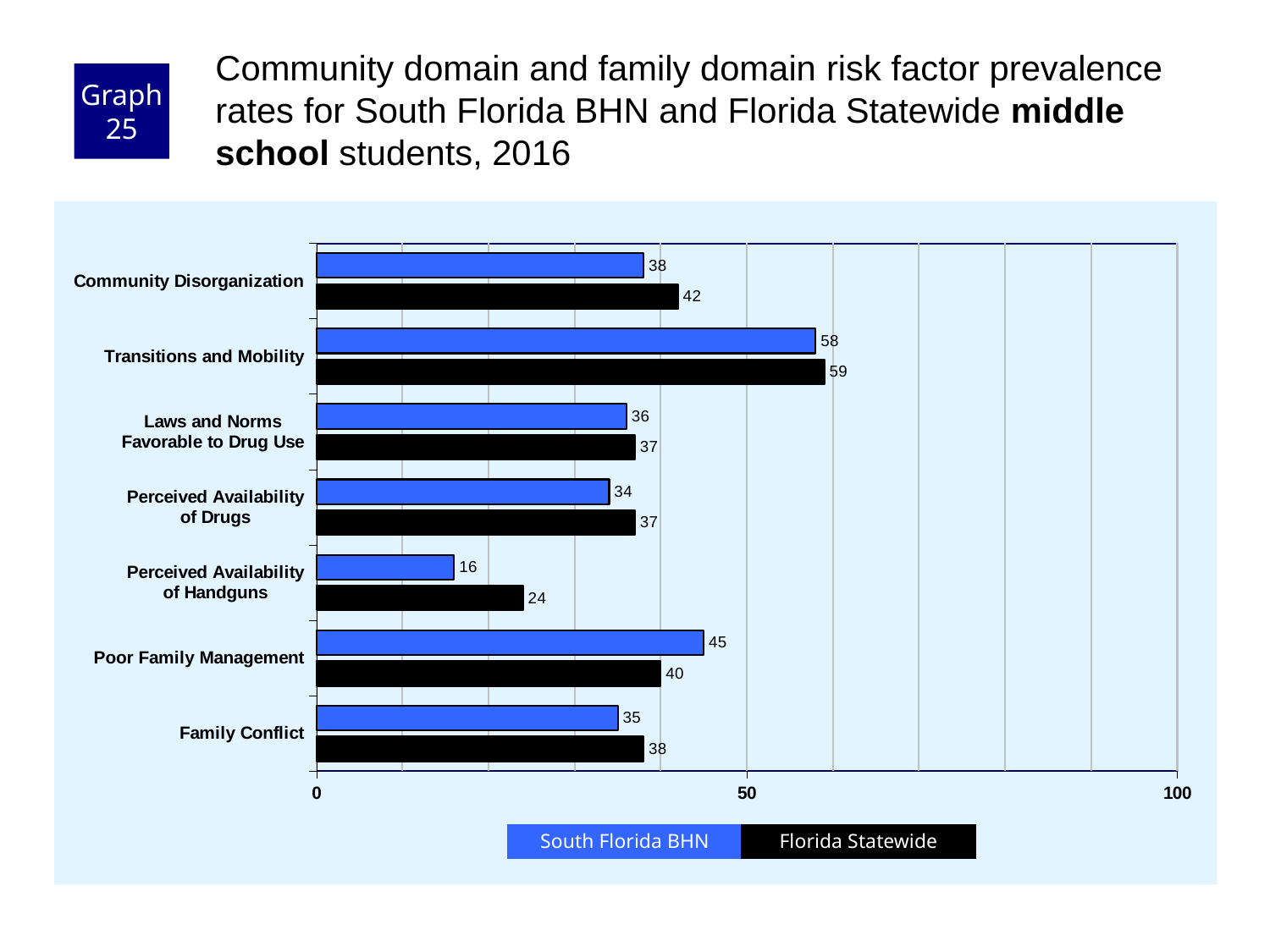
What is the Florida Statewide value for Poor Family Management? 40 What is the South Florida BHN value for Transitions and Mobility? 58 Which risk factor has the highest South Florida BHN value? Transitions and Mobility How many risk factor categories are shown on the chart? 7 Is the Florida Statewide value for Transitions and Mobility greater or less than 50? greater What is the difference between the South Florida BHN and Florida Statewide values for Poor Family Management? 5 Which risk factor has the lowest Florida Statewide value? Perceived Availability of Handguns For Community Disorganization, which is larger: the South Florida BHN value or the Florida Statewide value? Florida Statewide What is the Florida Statewide value for Perceived Availability of Handguns? 24 What kind of chart is shown on the slide? bar chart How many series does the legend list? 2 What is the difference between the Florida Statewide and South Florida BHN values for Perceived Availability of Handguns? 8